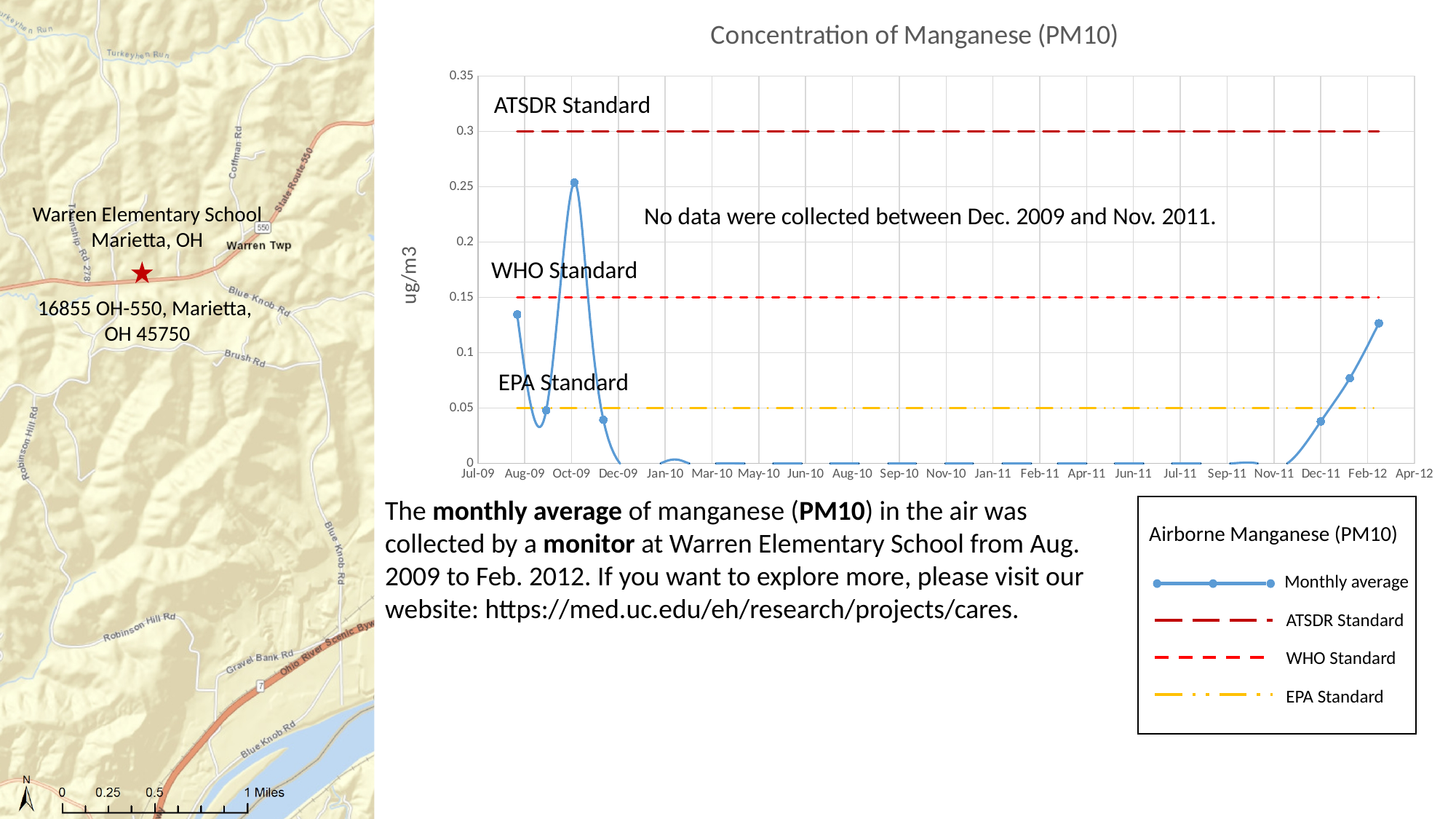
What is the title of the chart? Concentration of Manganese (PM10) Is the monthly average for Oct-09 greater or less than 0.2? greater Is the monthly average for Oct-09 greater or less than 0.3? less Which is larger, the monthly average for Dec-11 or for Feb-12? Feb-12 What kind of chart is shown on the slide? line chart Is the monthly average for Aug-09 greater or less than 0.1? greater In which month is the monthly average of manganese highest? Oct-09 Does the monthly average rise or fall from Dec-11 to Feb-12? rise What is the value of the ATSDR Standard line on the chart? 0.3 How many series does the chart legend list? 4 What is the value of the EPA Standard line on the chart? 0.05 What is the value of the WHO Standard line on the chart? 0.15